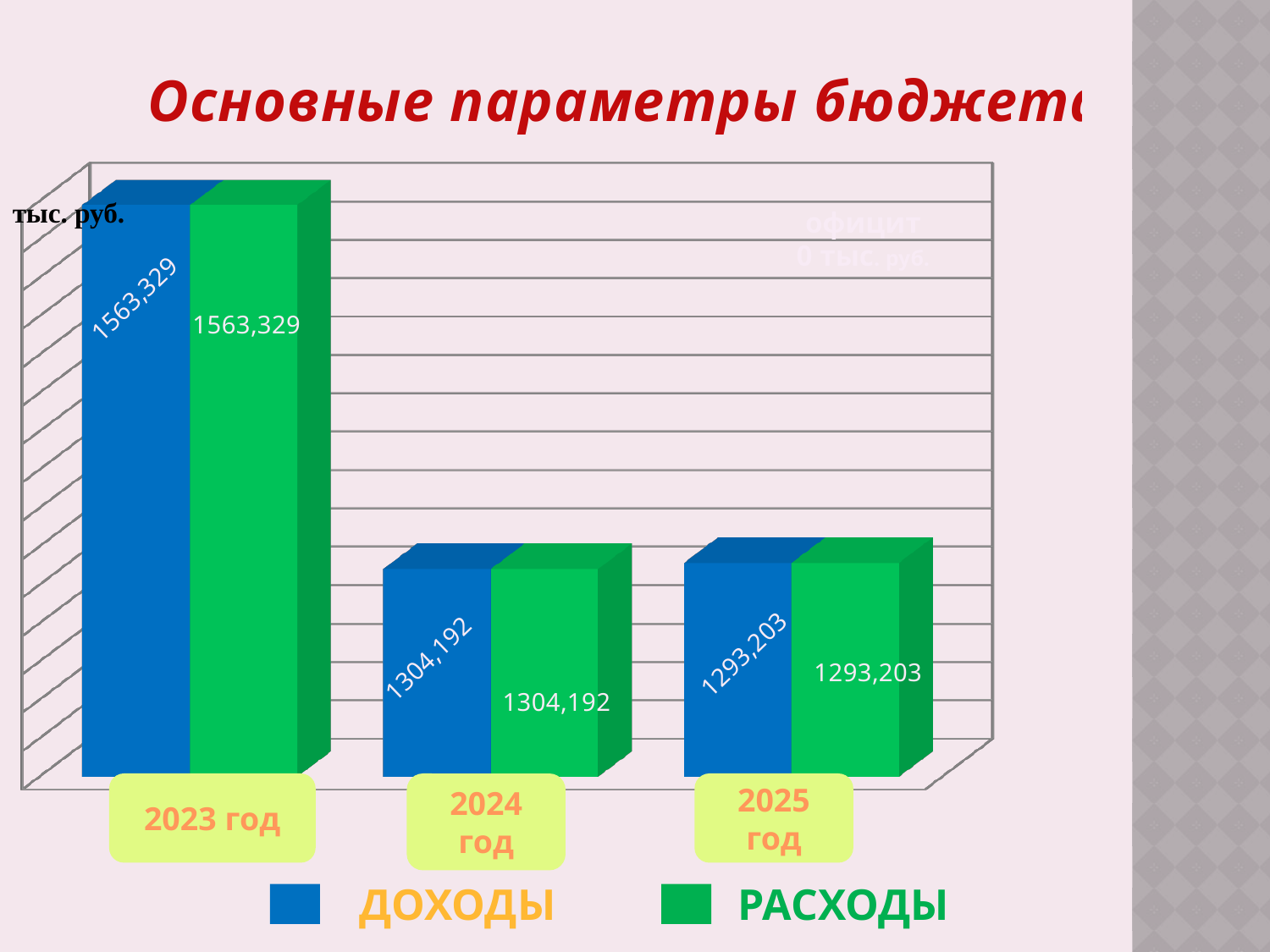
How many series does the legend list? 2 What is the difference between ДОХОДЫ in 2023 год and ДОХОДЫ in 2024 год? 259,137 What is the value of ДОХОДЫ for 2023 год? 1563,329 Do the ДОХОДЫ values rise or fall from 2023 год to 2025 год? fall What is the value of ДОХОДЫ for 2025 год? 1293,203 Which year has the lowest РАСХОДЫ value? 2025 год What is the value of РАСХОДЫ for 2024 год? 1304,192 How many years are shown on the x axis of the chart? 3 Which year has the highest ДОХОДЫ value? 2023 год What is the value of РАСХОДЫ for 2025 год? 1293,203 Which is larger: РАСХОДЫ in 2024 год or РАСХОДЫ in 2025 год? 2024 год What kind of chart is shown on the slide? bar chart